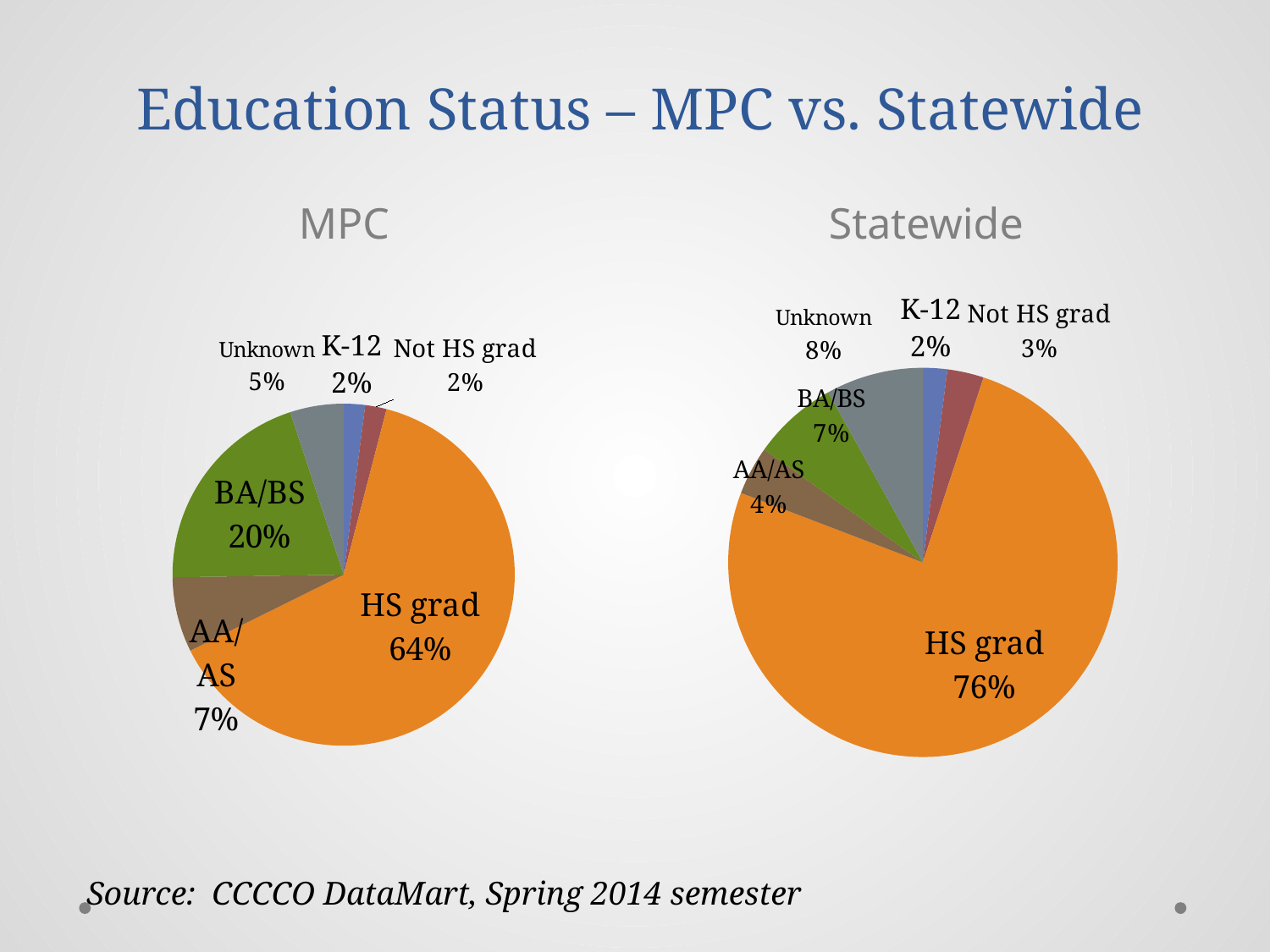
In the Statewide pie chart, what share is Unknown? 8% In the Statewide pie chart, what share is AA/AS? 4% What is the difference between the HS grad share in the Statewide chart and the HS grad share in the MPC chart? 12% In the MPC pie chart, what share is HS grad? 64% In the MPC pie chart, what share is BA/BS? 20% What type of chart is used for the Statewide data? Pie chart What is the title of the slide? Education Status – MPC vs. Statewide In the Statewide pie chart, what share is HS grad? 76% Which is larger: the BA/BS share in the MPC chart or the BA/BS share in the Statewide chart? MPC How many categories does the MPC pie chart show? 6 In the MPC pie chart, which category has the largest slice? HS grad In the Statewide pie chart, which category has the smallest slice? K-12